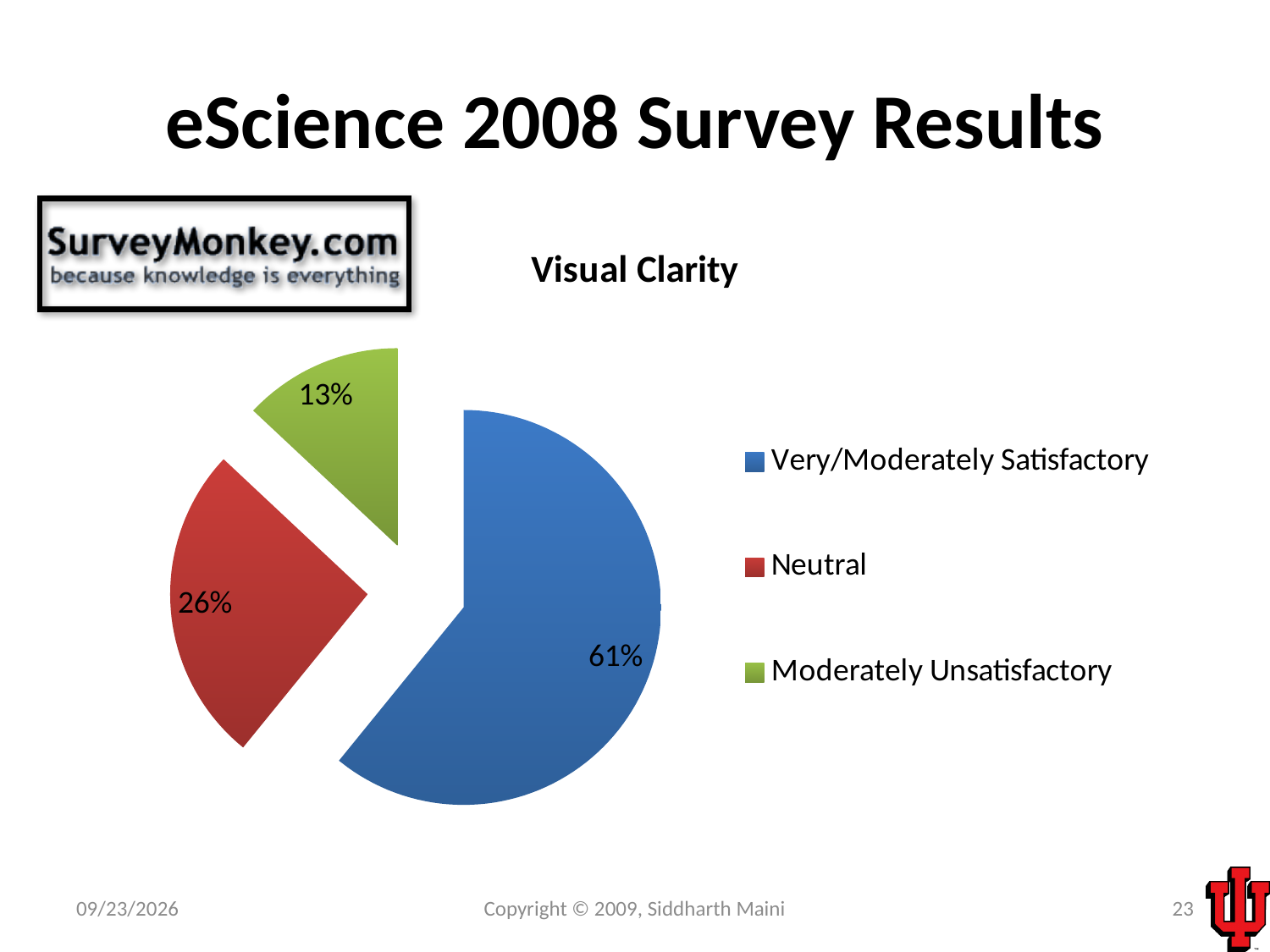
How many slices does the pie chart have? 3 What is the title of the chart? Visual Clarity What kind of chart is shown on the slide? Pie chart Which category has the largest slice of the pie? Very/Moderately Satisfactory Which category has the smallest slice of the pie? Moderately Unsatisfactory What share of the pie is labelled Moderately Unsatisfactory? 13% What is the difference in percentage points between the Very/Moderately Satisfactory slice and the Neutral slice? 35 What share of the pie is labelled Very/Moderately Satisfactory? 61% Which is larger, the Neutral slice or the Moderately Unsatisfactory slice? Neutral What share of the pie is labelled Neutral? 26% What is the difference in percentage points between the Neutral slice and the Moderately Unsatisfactory slice? 13 What colour is the Neutral slice in the pie chart? Red